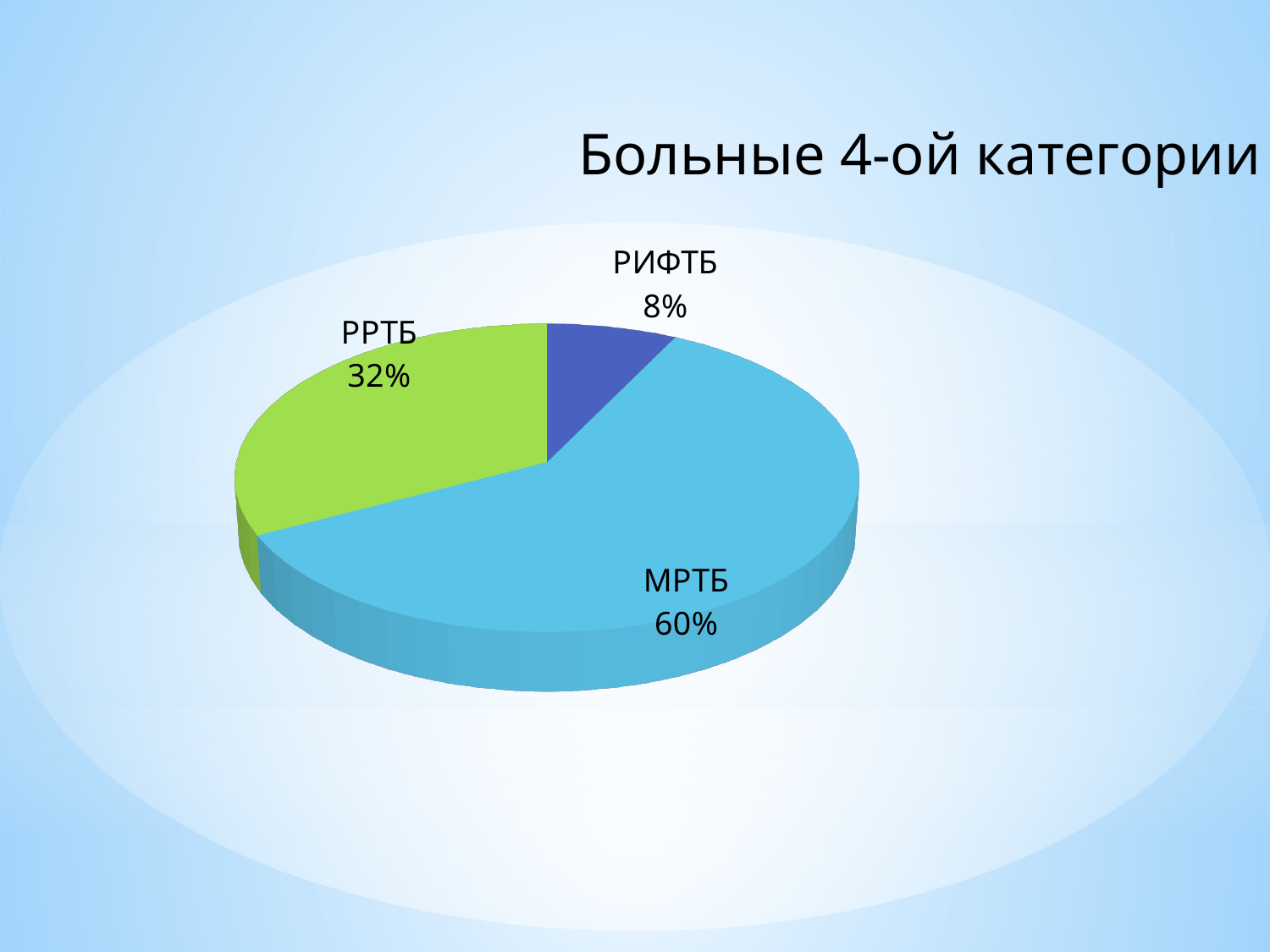
Which category has the largest slice? МРТБ What share of the pie does РРТБ have? 32% Which category has the smallest slice? РИФТБ What is the difference between the shares of МРТБ and РРТБ? 28% What share of the pie does МРТБ have? 60% What colour is the МРТБ slice? light blue What share of the pie does РИФТБ have? 8% How many slices does the pie chart have? 3 What is the title of the chart? Больные 4-ой категории Which is larger, the share of РРТБ or the share of РИФТБ? РРТБ What is the difference between the shares of РРТБ and РИФТБ? 24% What kind of chart is shown on the slide? pie chart